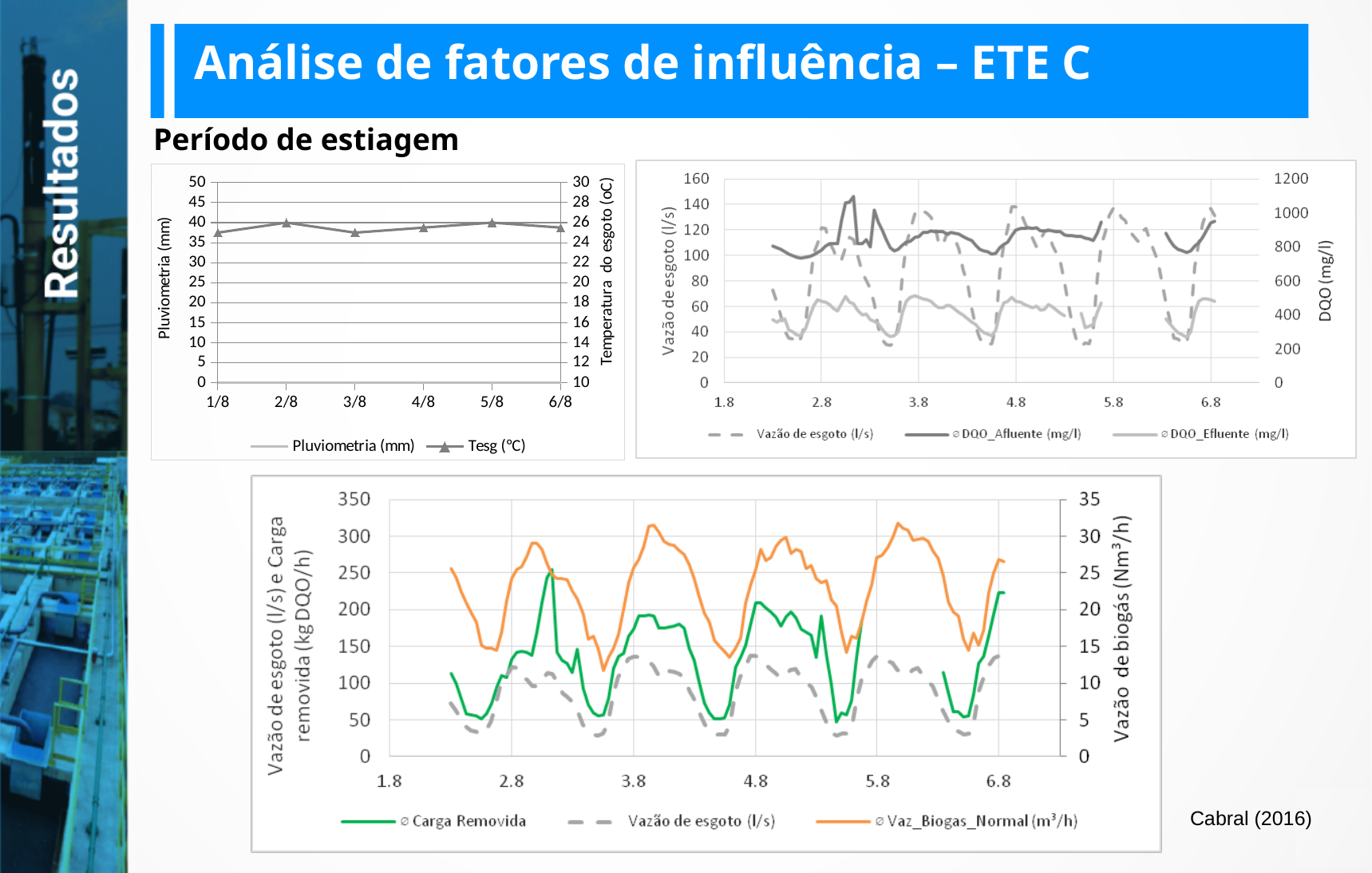
Which series in the bottom chart is drawn in orange? Vaz_Biogas_Normal (m³/h) How many series does the legend of the top-left chart list? 2 How many dates are shown on the x axis of the top-left chart? 6 In the top-left chart, is the Pluviometria (mm) value at 3/8 greater or less than 5? less How many series does the legend of the bottom chart list? 3 What kind of chart is the top-left chart (Pluviometria and Tesg)? line chart What is the label of the right-hand vertical axis of the top-right chart? DQO (mg/l) In the top-left chart, which is higher: the Tesg (°C) value at 2/8 or at 3/8? 2/8 In the top-left chart, is the Tesg (°C) value at 2/8 greater or less than 20? greater What kind of chart is the bottom chart? line chart How many series does the legend of the top-right chart list? 3 In the bottom chart, is the highest value of Carga Removida greater or less than 300? less